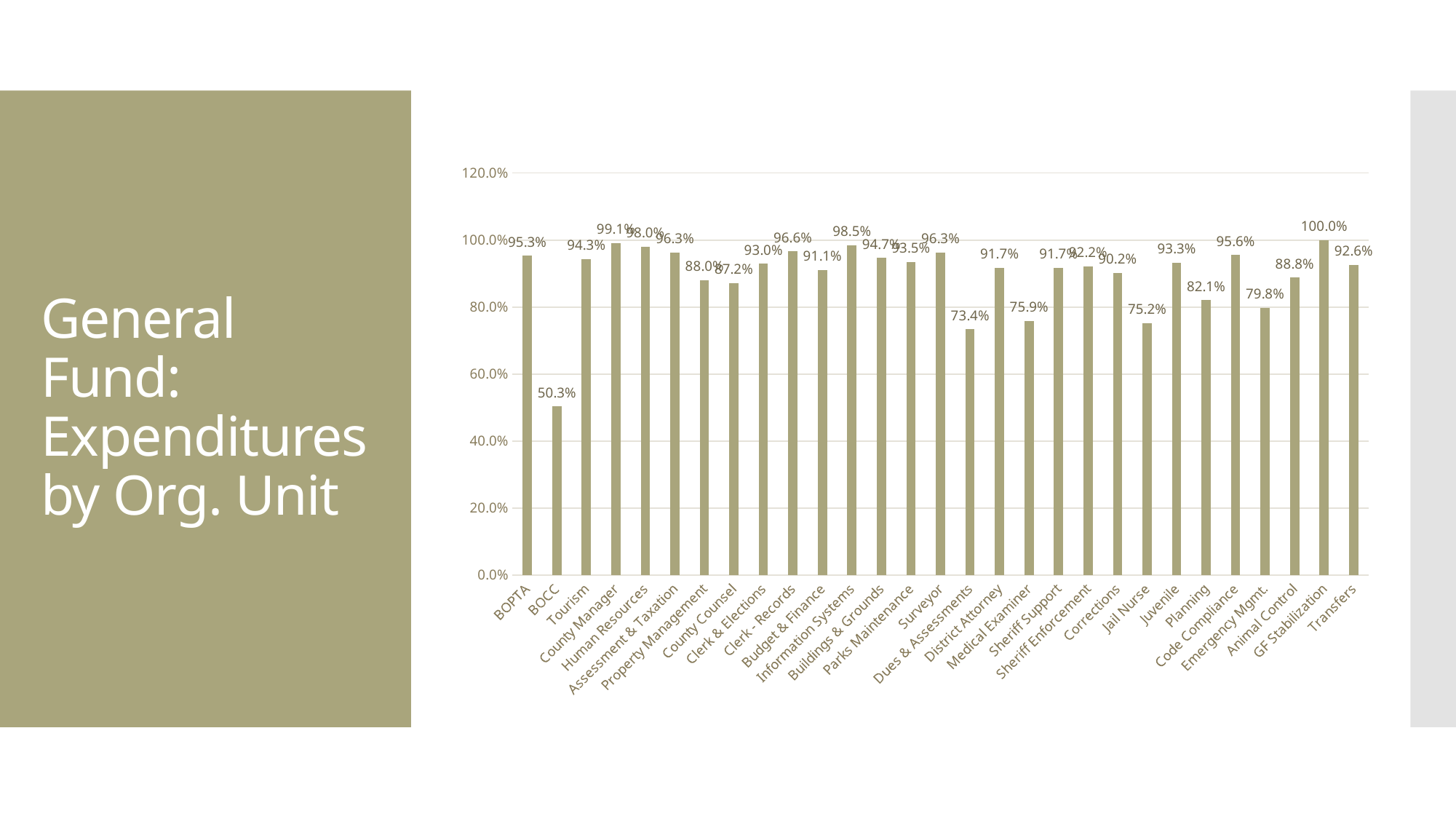
What is the difference between the values for Dues & Assessments and Medical Examiner? 2.5% What is the difference between the values for County Manager and Planning? 17.0% What is the value for Jail Nurse? 75.2% Is the value for Animal Control greater or less than 80.0%? greater Which org. unit has the lowest value? BOCC What kind of chart is shown on the slide? Bar chart Which org. unit has the highest value? GF Stabilization Which is larger, the value for Tourism or the value for Corrections? Tourism How many org. units are shown on the x axis? 29 What is the value for BOCC? 50.3% What is the value for Emergency Mgmt.? 79.8% What is the value for Information Systems? 98.5%